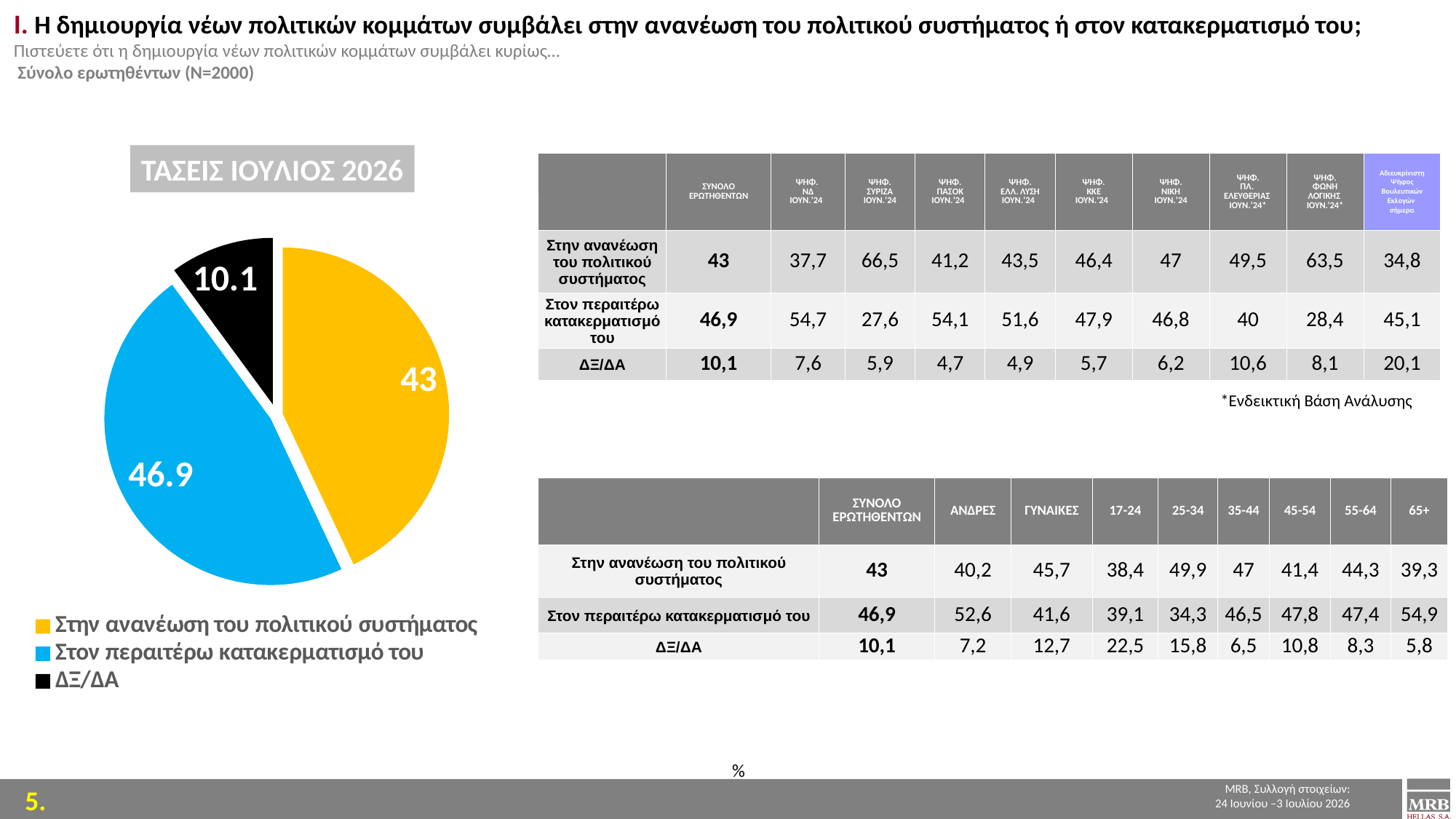
In the pie chart, which is larger: 'Στην ανανέωση του πολιτικού συστήματος' or 'ΔΞ/ΔΑ'? Στην ανανέωση του πολιτικού συστήματος In the pie chart, what is the difference between the value for 'Στον περαιτέρω κατακερματισμό του' and the value for 'Στην ανανέωση του πολιτικού συστήματος'? 3.9 How many slices does the pie chart have? 3 What colour is the 'ΔΞ/ΔΑ' slice in the pie chart? Black Which slice of the pie chart is the largest? Στον περαιτέρω κατακερματισμό του In the pie chart, what is the value for 'ΔΞ/ΔΑ'? 10.1 What is the title shown above the pie chart? ΤΑΣΕΙΣ ΙΟΥΛΙΟΣ 2026 What type of chart is shown on the left of the slide? Pie chart In the pie chart, what is the value for 'Στον περαιτέρω κατακερματισμό του'? 46.9 In the pie chart, what is the value for 'Στην ανανέωση του πολιτικού συστήματος'? 43 Which slice of the pie chart is the smallest? ΔΞ/ΔΑ How many entries does the pie chart's legend list? 3